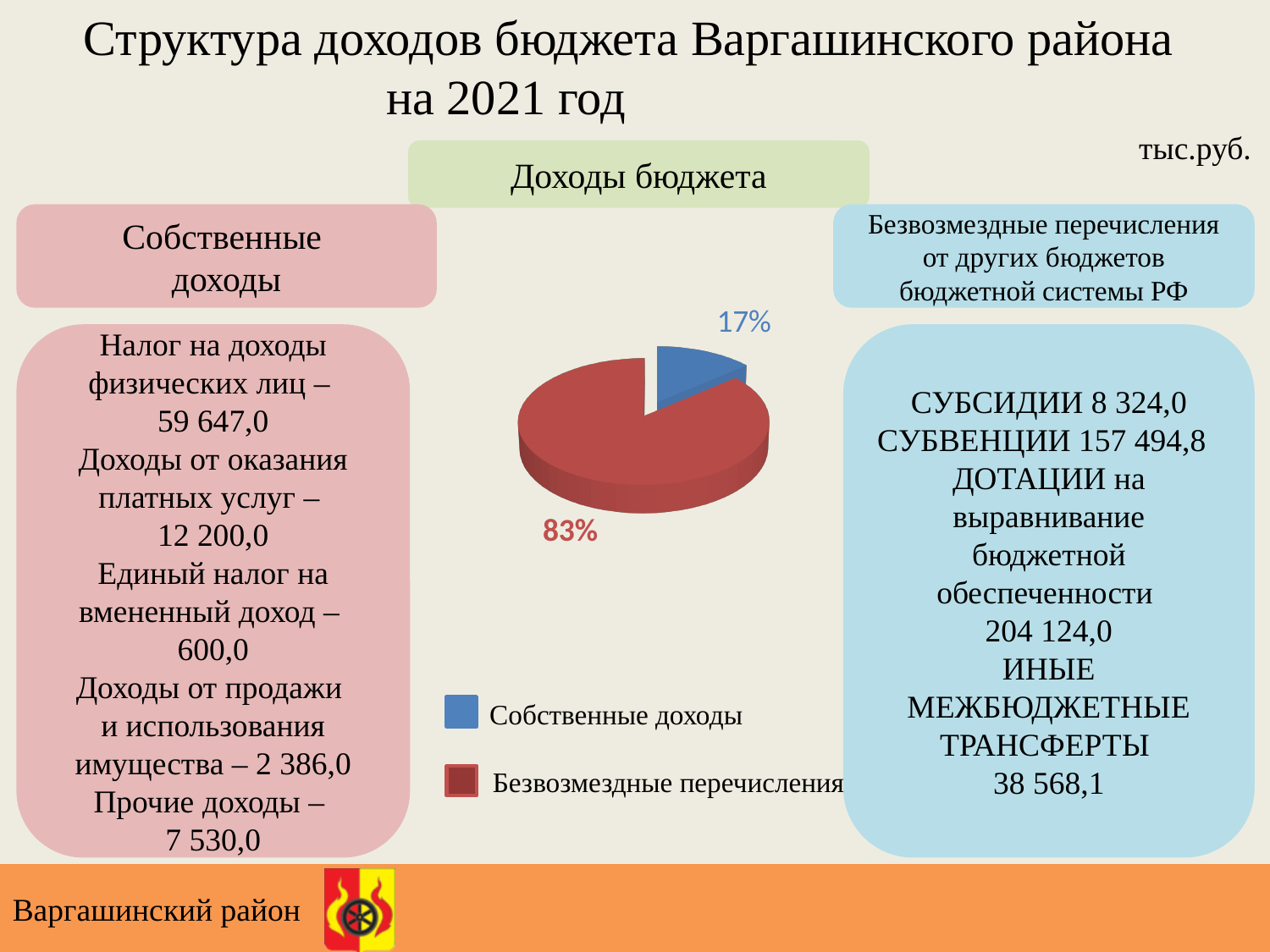
What is the difference in percentage points between Безвозмездные перечисления and Собственные доходы? 66 What share of the pie does Безвозмездные перечисления take? 83% What colour is the slice for Собственные доходы? Blue Which slice of the pie is the largest? Безвозмездные перечисления How many slices does the pie chart have? 2 How many entries does the legend list? 2 What share of the pie does Собственные доходы take? 17% What colour is the slice for Безвозмездные перечисления? Red Which slice of the pie is the smallest? Собственные доходы What kind of chart is shown on the slide? Pie chart Which is larger: Собственные доходы or Безвозмездные перечисления? Безвозмездные перечисления